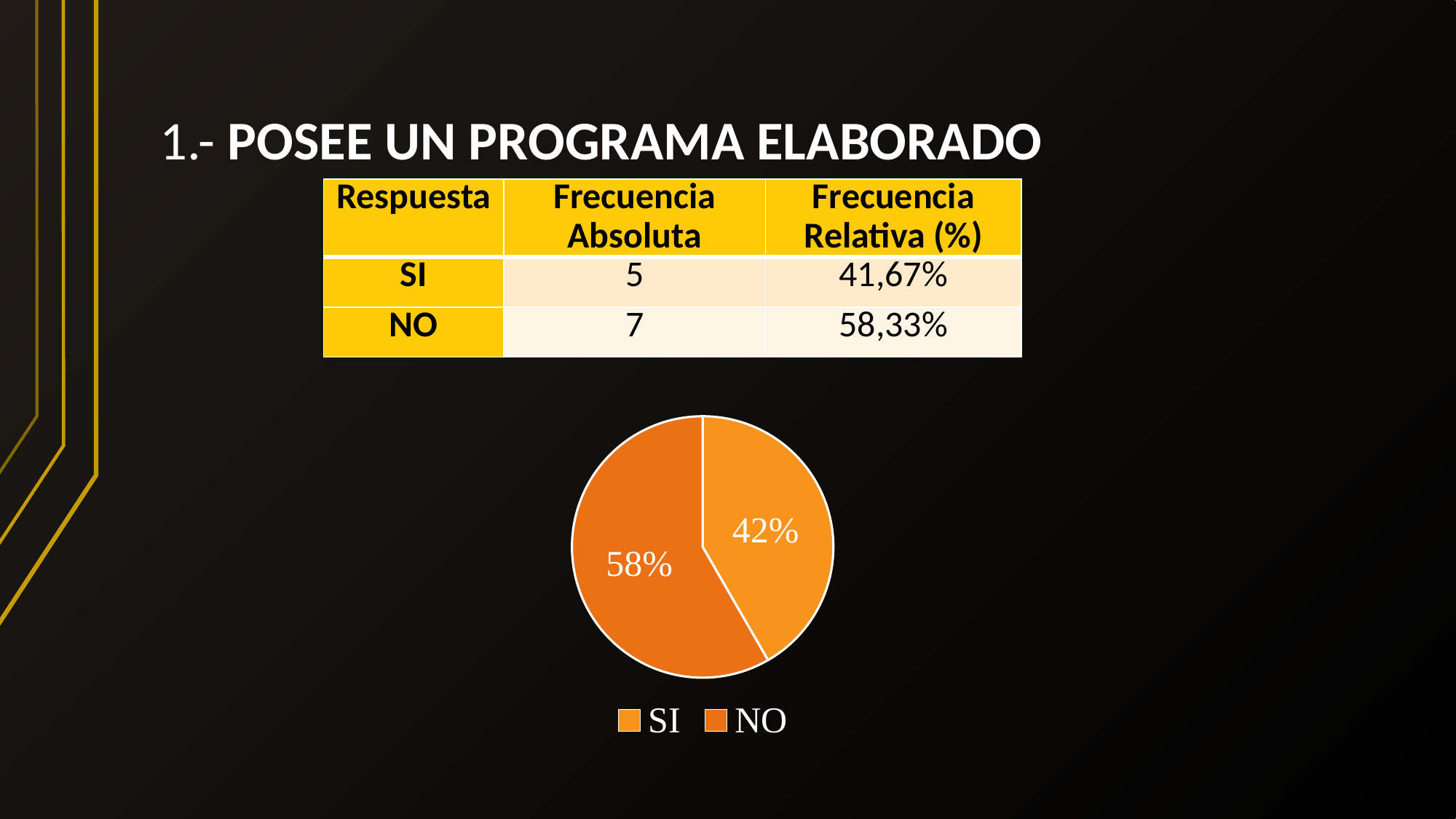
Is the share of the NO slice in the pie chart greater or less than 50%? greater Which slice of the pie chart is the smallest? SI What is the difference in percentage points between the NO slice and the SI slice in the pie chart? 16 Which slice of the pie chart is the largest? NO How many entries does the pie chart legend list? 2 What are the legend entries of the pie chart? SI, NO What percentage does the NO slice show in the pie chart? 58% How many slices does the pie chart have? 2 Which legend entry in the pie chart is shown in the darker orange colour? NO What kind of chart is shown on the slide? pie chart What percentage does the SI slice show in the pie chart? 42% Which slice is larger in the pie chart, SI or NO? NO